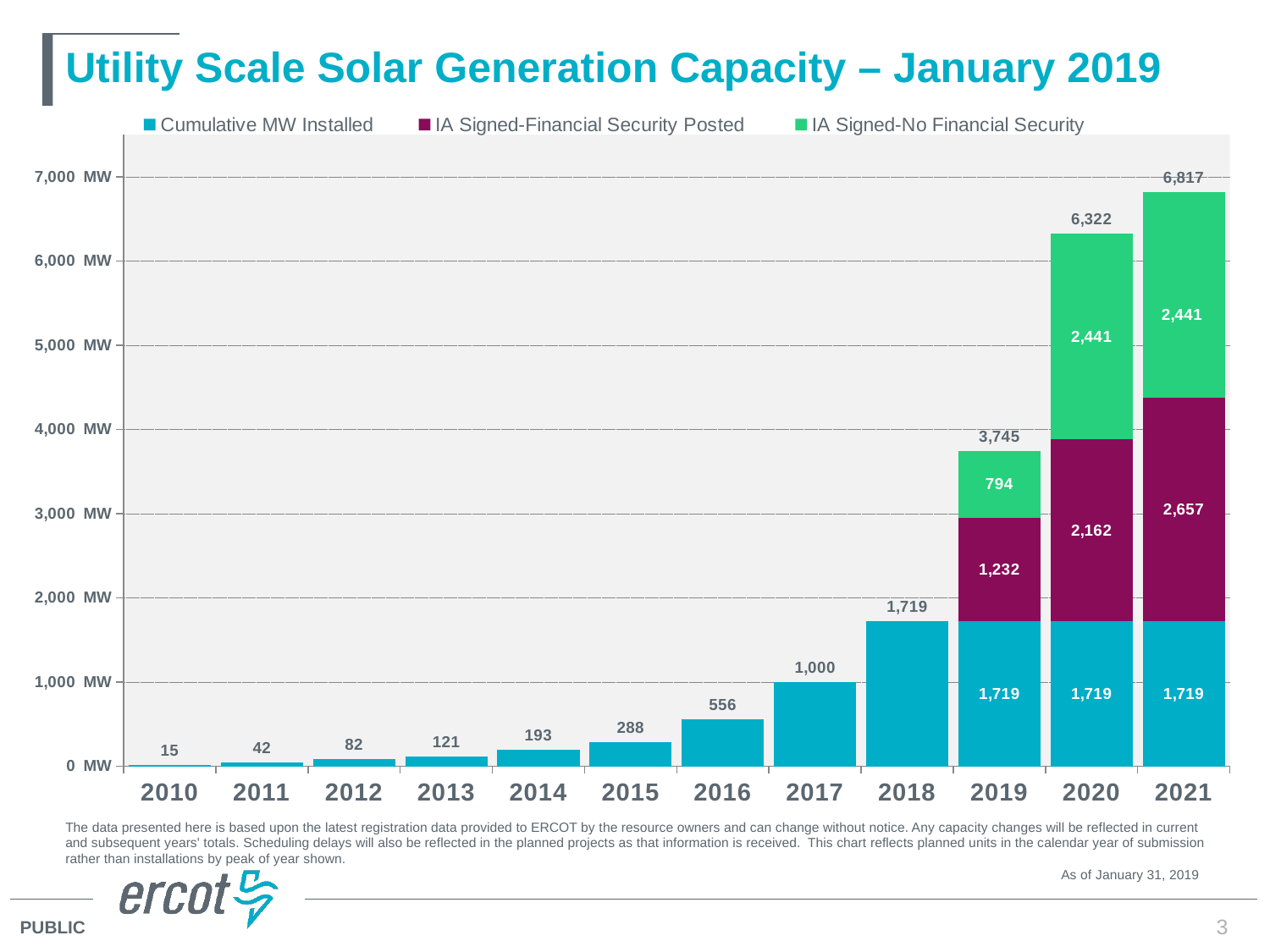
Which year has the highest stacked bar total? 2021 What is the Cumulative MW Installed value for 2016? 556 How many series does the legend list? 3 Which is larger: the IA Signed-Financial Security Posted value for 2021 or for 2019? 2021 What is the IA Signed-No Financial Security value for 2019? 794 What is the total of the stacked bar for 2021? 6,817 Which year has the lowest Cumulative MW Installed value? 2010 What is the IA Signed-Financial Security Posted value for 2020? 2,162 What is the difference between the Cumulative MW Installed values for 2018 and 2017? 719 What kind of chart is shown on the slide? Stacked bar chart How many years are shown on the x axis? 12 Is the stacked bar total for 2020 greater or less than 6,000 MW? greater